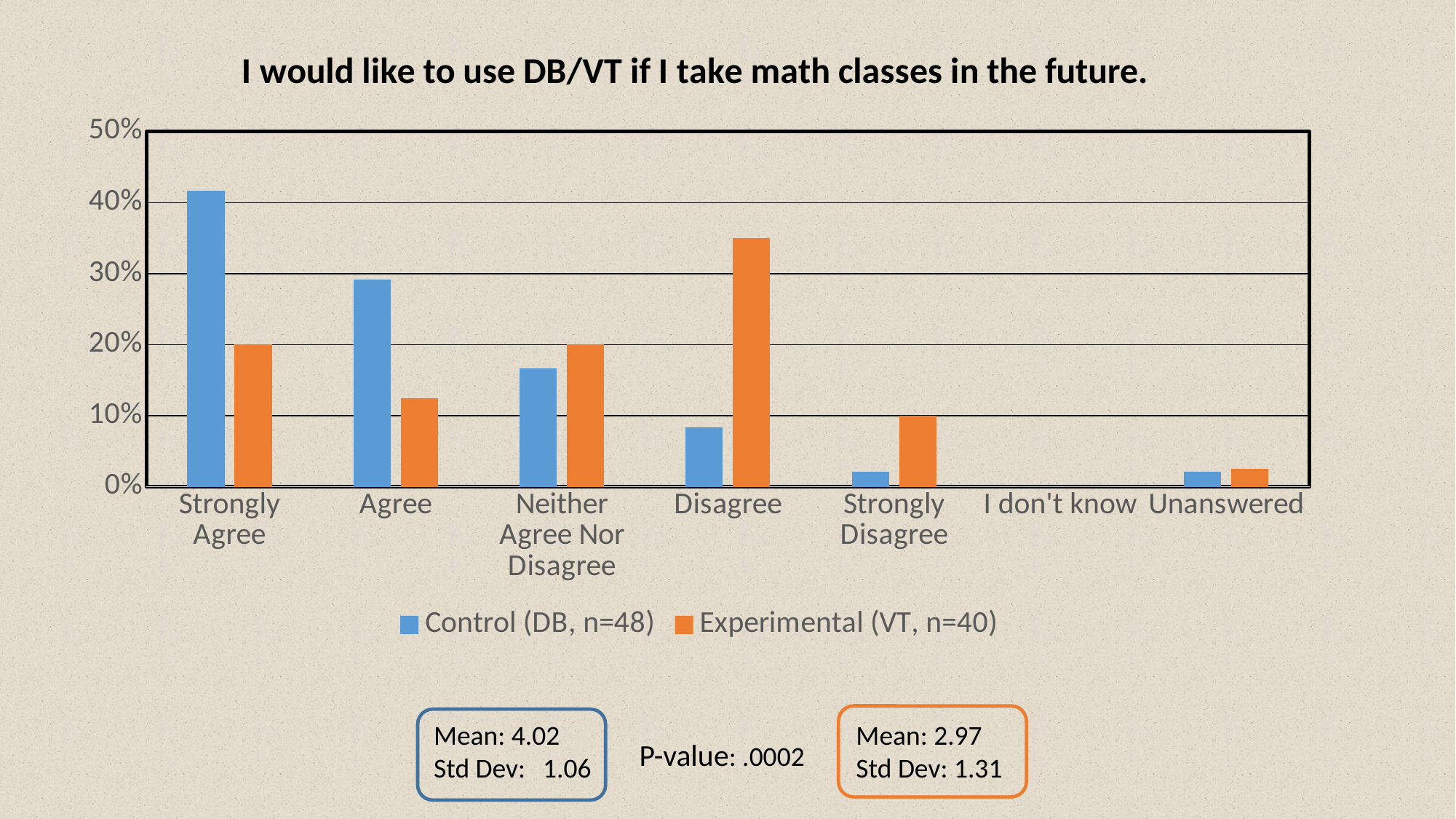
Is the Control (DB, n=48) value for Disagree greater or less than 10%? less For the Strongly Agree category, which series has the larger value, Control or Experimental? Control (DB, n=48) How many response categories are shown on the x axis? 7 Do the Control (DB, n=48) values rise or fall moving from Strongly Agree to Strongly Disagree? fall How many series does the legend list? 2 Is the Control (DB, n=48) value for Strongly Agree greater or less than 40%? greater What kind of chart is shown on the slide? bar chart For the Disagree category, which series has the larger value, Control or Experimental? Experimental (VT, n=40) Which category has the highest value for the Control (DB, n=48) series? Strongly Agree Is the Experimental (VT, n=40) value for Disagree greater or less than 30%? greater What is the title of the chart? I would like to use DB/VT if I take math classes in the future. Which category has the highest value for the Experimental (VT, n=40) series? Disagree